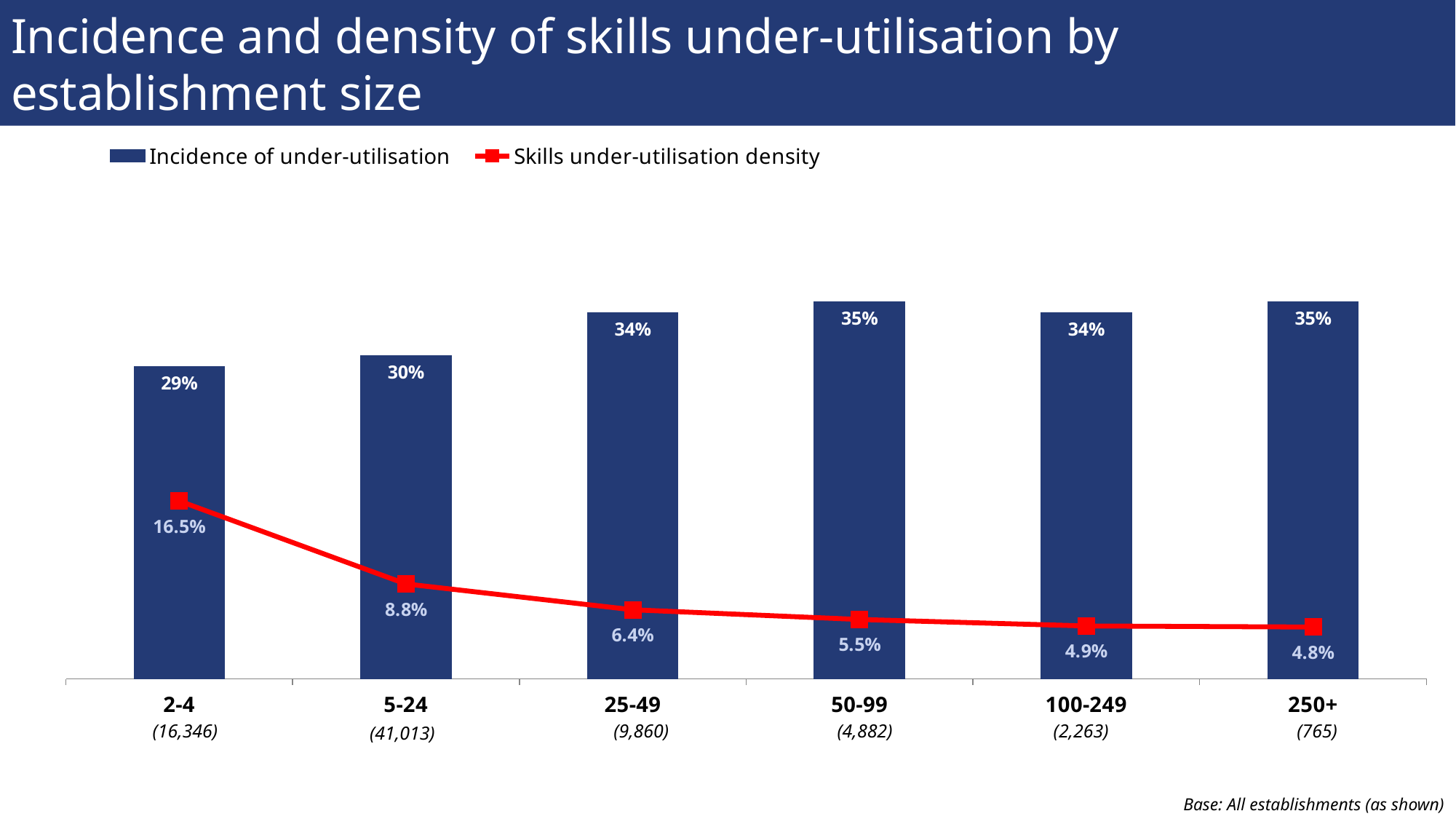
What is the skills under-utilisation density for establishments of size 250+? 4.8% Does the skills under-utilisation density rise or fall as establishment size increases? Fall Which has a higher skills under-utilisation density, 25-49 or 100-249? 25-49 What is the difference in incidence of under-utilisation between the 50-99 and 2-4 establishment sizes? 6 percentage points What colour is the line for skills under-utilisation density? Red What is the difference in skills under-utilisation density between the 2-4 and 5-24 establishment sizes? 7.7 percentage points What is the skills under-utilisation density for establishments of size 5-24? 8.8% Which establishment size has the highest skills under-utilisation density? 2-4 How many establishment size categories are shown on the chart? 6 What is the incidence of under-utilisation for establishments of size 2-4? 29% How many series does the legend list? 2 Which establishment size has the lowest incidence of under-utilisation? 2-4